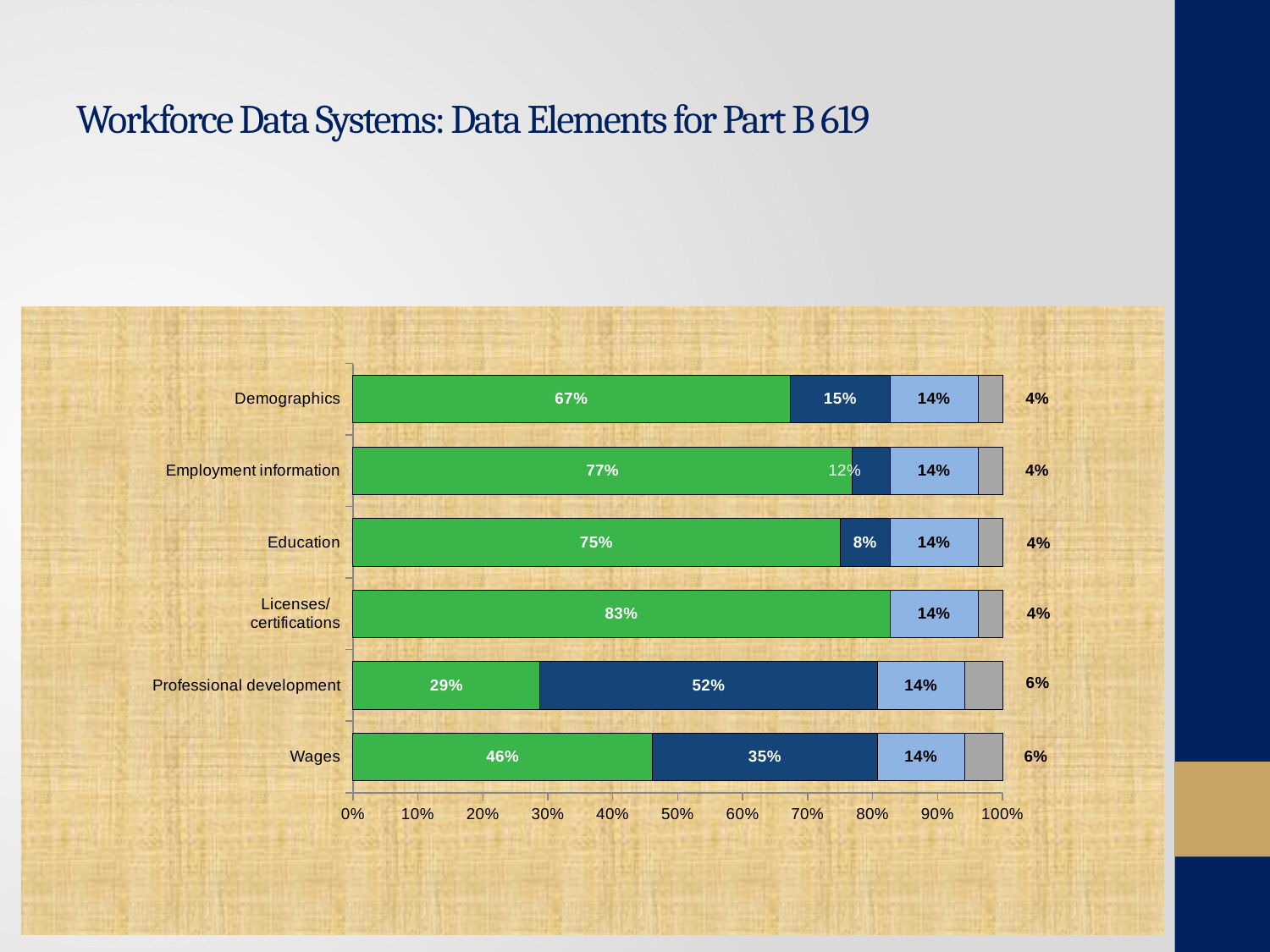
Which category has the largest green segment? Licenses/certifications What is the value of the dark blue segment for Education? 8% What is the value of the green segment for Demographics? 67% What is the title of the slide? Workforce Data Systems: Data Elements for Part B 619 What is the value printed at the right end of the Professional development bar? 6% What kind of chart is shown on the slide? Stacked bar chart How many categories are plotted on the chart? 6 Which has the larger dark blue segment, Professional development or Wages? Professional development Which category has the smallest green segment? Professional development What is the value of the dark blue segment for Wages? 35% Is the green segment for Education greater or less than 70%? greater For Wages, what is the difference between the green segment and the dark blue segment? 11 percentage points